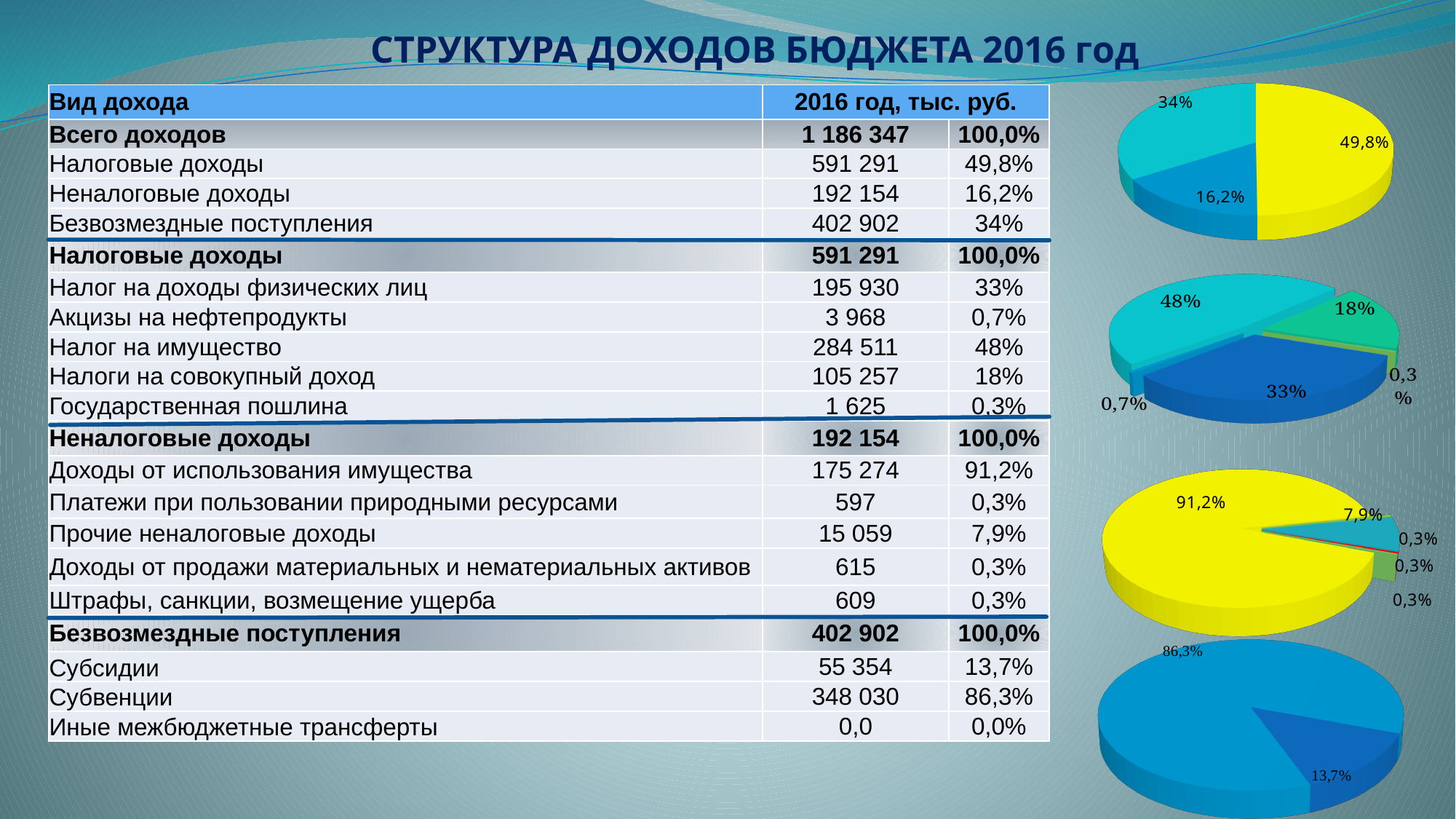
In the second pie chart from the top, how many slices are there? 5 In the second pie chart from the top, what is the difference between the 48% slice and the 33% slice? 15% In the top pie chart, what is the share of the largest slice? 49,8% In the bottom pie chart, how many slices are there? 2 How many pie charts are shown on the slide? 4 In the third pie chart from the top, what is the share of the largest slice? 91,2% In the top pie chart, what share is labelled on the yellow slice? 49,8% In the bottom pie chart, what is the difference between the two slices' shares? 72,6% In the top pie chart, how many slices are there? 3 What kind of chart is the top chart on the right side of the slide? pie chart In the top pie chart, what is the share of the smallest slice? 16,2% In the second pie chart from the top, what is the share of the largest slice? 48%